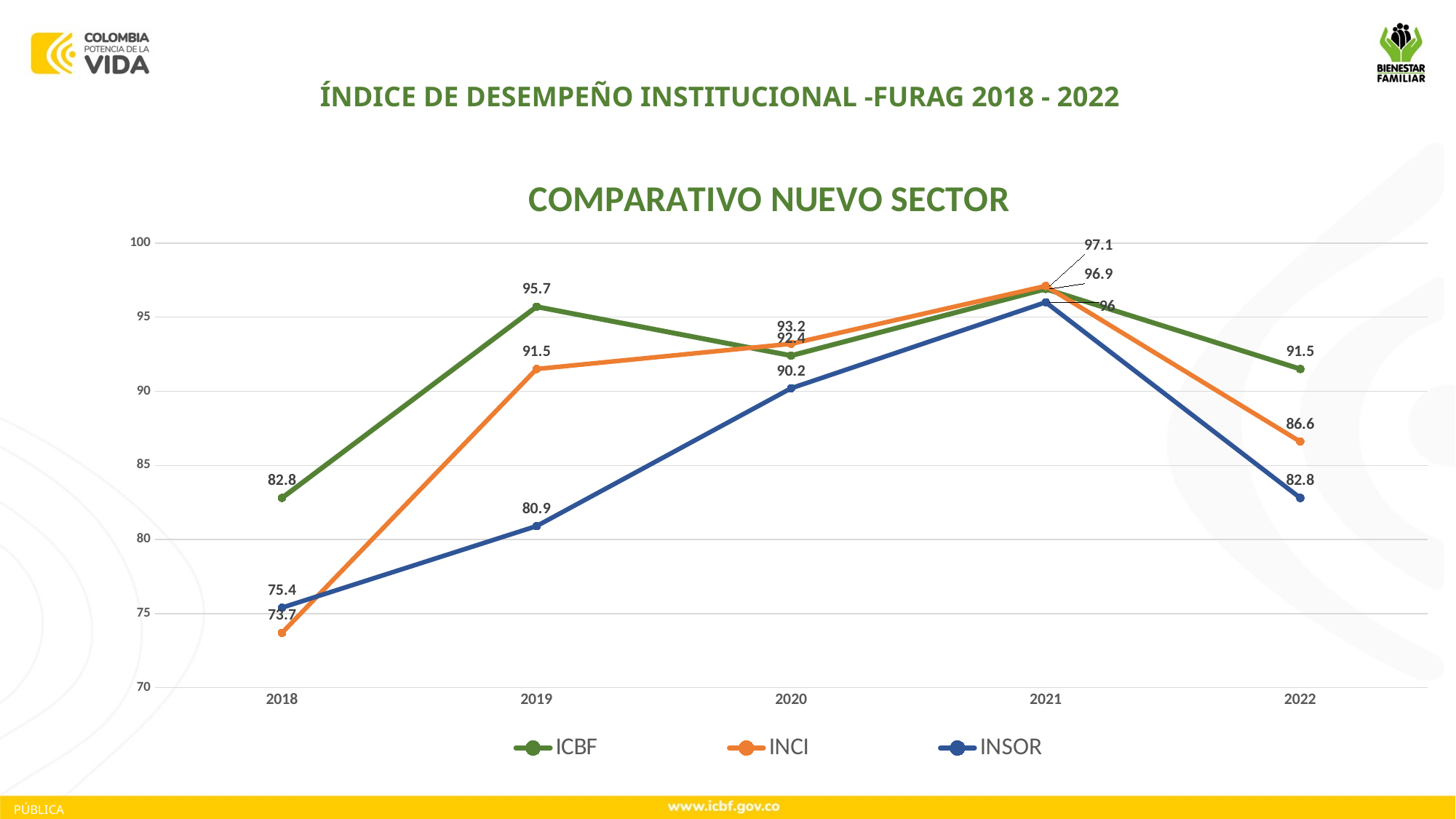
What is the title of the chart? COMPARATIVO NUEVO SECTOR What is the ICBF value for 2019? 95.7 How many series does the legend list? 3 What is the INSOR value for 2020? 90.2 What is the INCI value for 2018? 73.7 What is the difference between the ICBF value in 2019 and the INCI value in 2019? 4.2 Which series has the higher value in 2022, INCI or INSOR? INCI In which year does ICBF reach its highest value? 2021 In which year does INSOR have its lowest value? 2018 Does the INSOR value rise or fall from 2021 to 2022? fall What type of chart is shown on the slide? line chart How many years are plotted along the x axis? 5